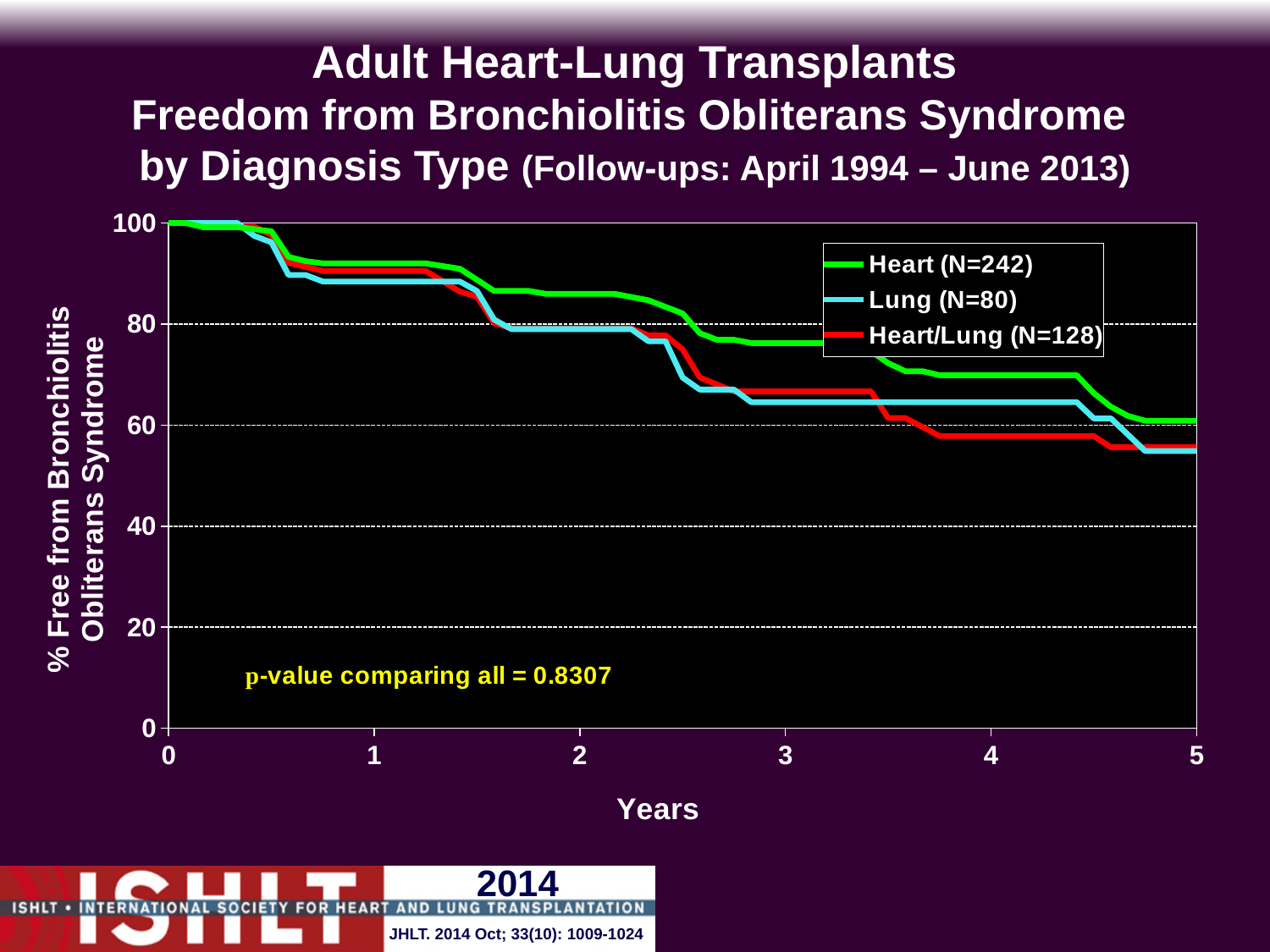
Is the value for Lung at 5 years greater or less than 60? less At 3 years, which is higher: Heart or Lung? Heart Is the value for Heart/Lung at 4 years greater or less than 60? less At 4 years, which is higher: Heart or Heart/Lung? Heart What is the N for the Lung group in the legend? 80 Is the value for Heart at 2 years greater or less than 80? greater What is the p-value comparing all groups shown on the chart? 0.8307 Which diagnosis group has the highest freedom from bronchiolitis obliterans syndrome at 5 years? Heart How many series does the legend list? 3 What kind of chart is shown on the slide? line chart Do the curves rise or fall as years since transplant increase? fall